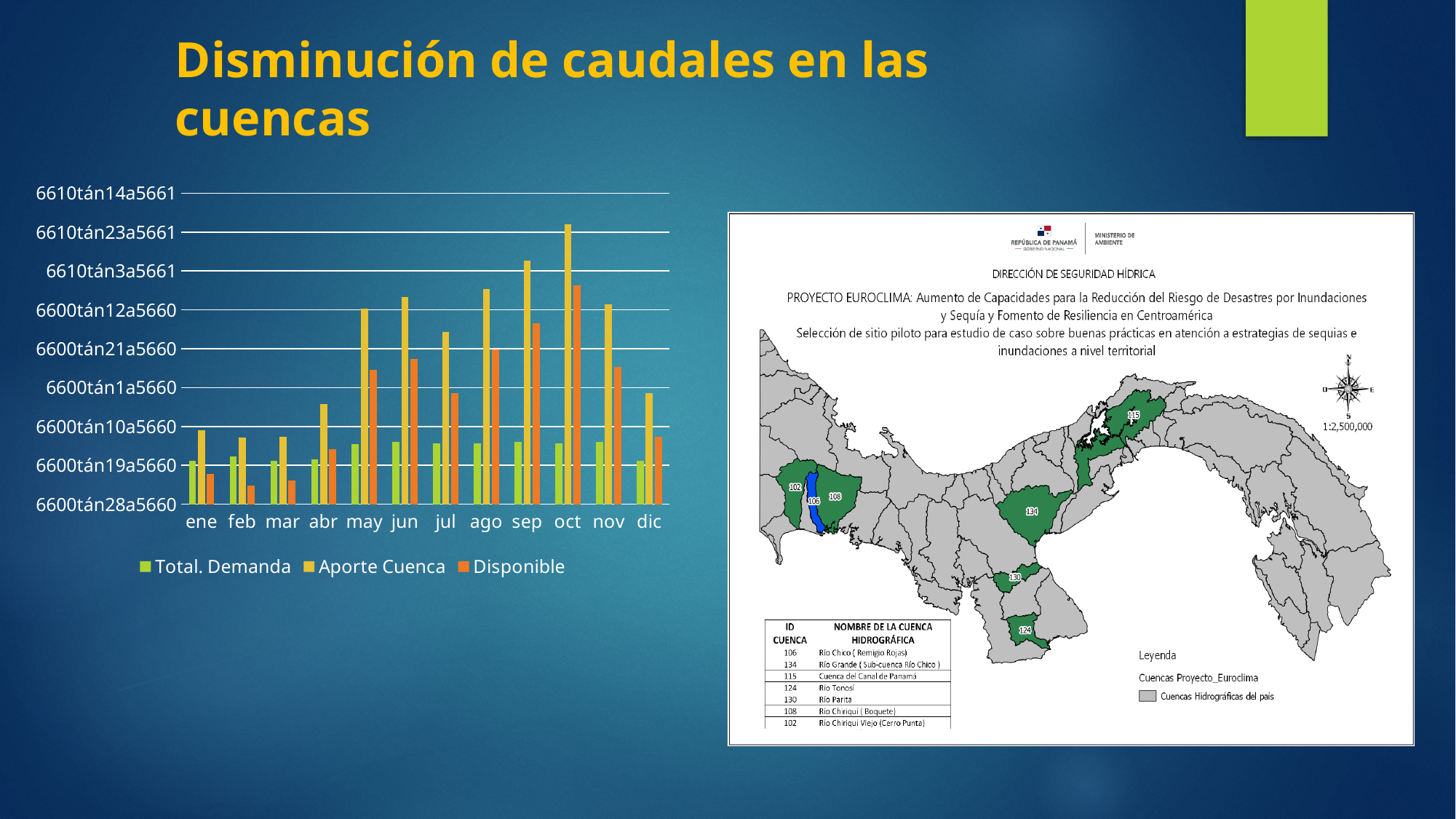
How many months (categories) are shown on the x axis of the bar chart? 12 How many series does the legend of the bar chart list? 3 Which is larger, the Disponible bar for may or for jun? jun Do the Aporte Cuenca bars rise or fall from oct to dic? fall Which colour represents the Disponible series in the bar chart? orange What are the three series named in the legend of the bar chart? Total. Demanda, Aporte Cuenca, Disponible What kind of chart is shown on the left of the slide? bar chart Do the Aporte Cuenca bars generally rise or fall from ene to oct? rise Which is larger, the Aporte Cuenca bar for jun or for jul? jun Which is larger, the Aporte Cuenca bar for sep or for oct? oct In which month is the Disponible bar highest? oct In which month is the Aporte Cuenca bar highest? oct